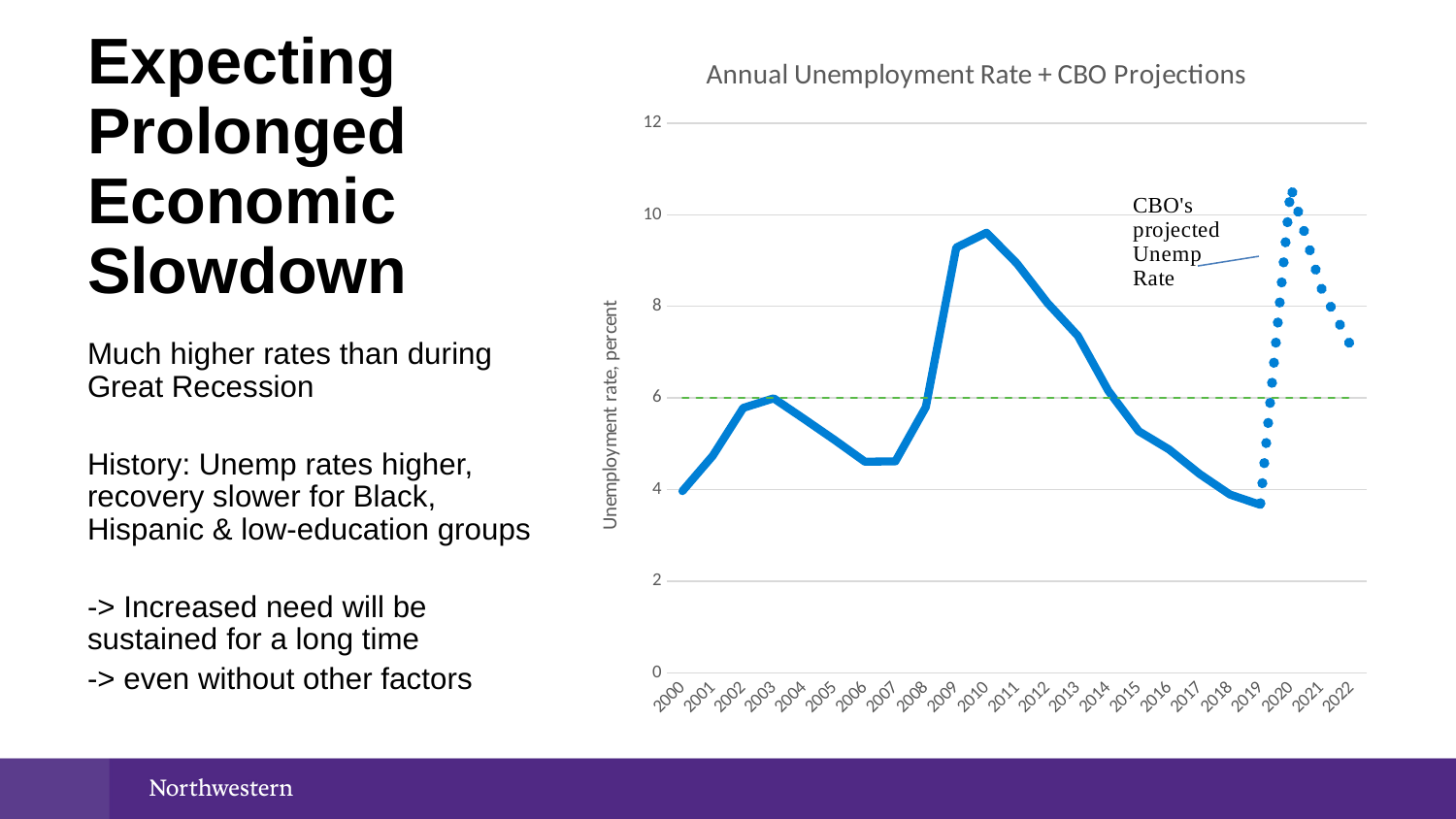
Which year has a higher unemployment rate, 2009 or 2007? 2009 Does the unemployment rate rise or fall from 2010 to 2019? fall How many years are shown along the x axis of the chart? 23 What kind of chart is shown on the slide? line chart What is the label on the vertical axis of the chart? Unemployment rate, percent Is the unemployment rate for 2010 greater or less than 8? greater Is the projected unemployment rate for 2022 greater or less than 8? less Among the actual (solid line) years 2000 to 2019, which year has the highest unemployment rate? 2010 Is the unemployment rate for 2006 greater or less than 6? less Which year has the lowest unemployment rate on the chart? 2019 What is the title of the chart? Annual Unemployment Rate + CBO Projections